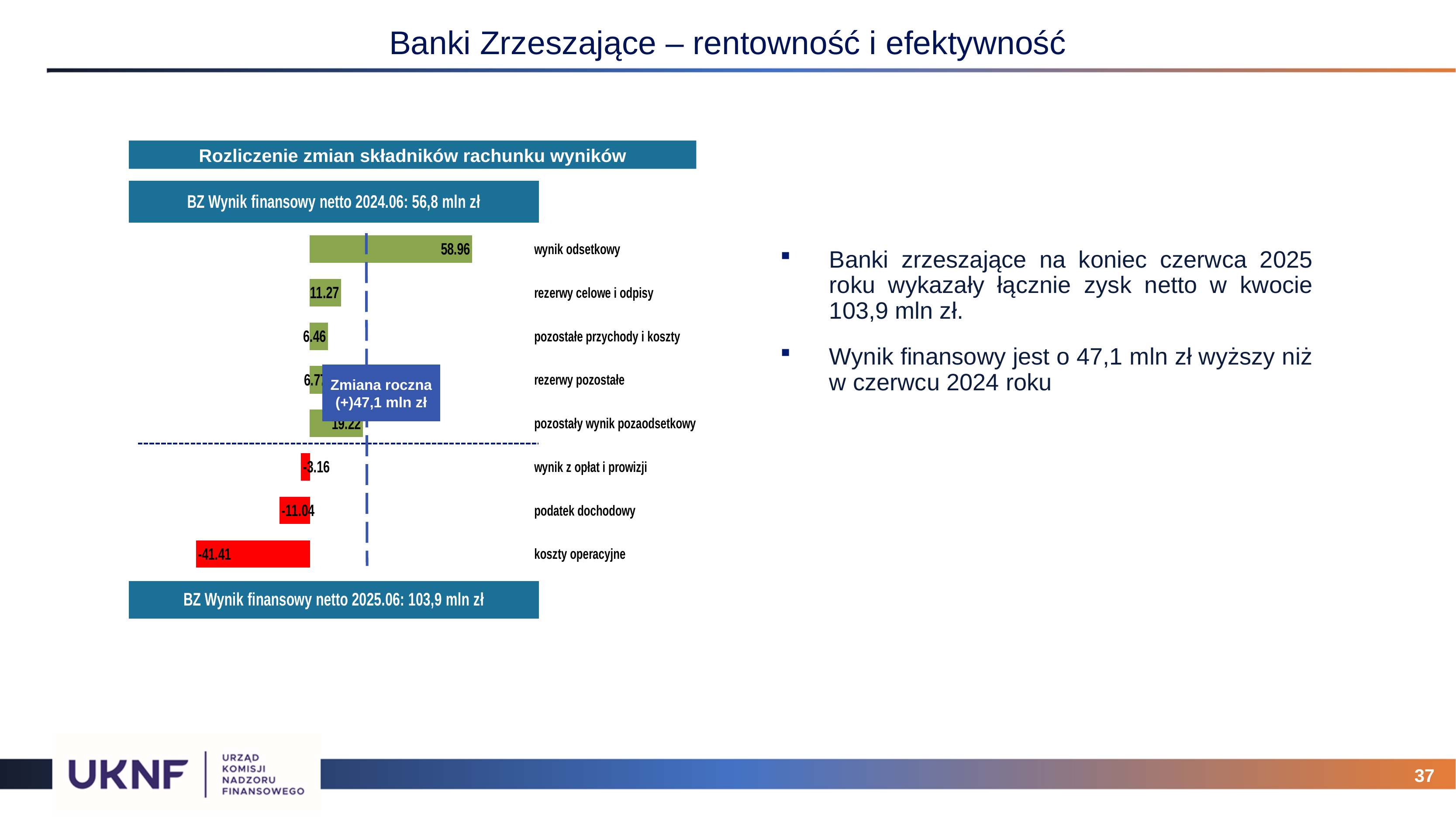
What is the difference between the values for 'wynik odsetkowy' and 'pozostały wynik pozaodsetkowy'? 39.74 How many categories are plotted in the chart? 8 What is the value shown for 'podatek dochodowy'? -11.04 Which category has the lowest value in the chart? koszty operacyjne What is the value shown for 'wynik z opłat i prowizji'? -3.16 Which is larger: the value for 'rezerwy celowe i odpisy' or for 'pozostałe przychody i koszty'? rezerwy celowe i odpisy What is the value shown for 'rezerwy celowe i odpisy'? 11.27 Which category has the highest value in the chart? wynik odsetkowy What type of chart is shown on the slide? bar chart What is the value shown for 'wynik odsetkowy'? 58.96 What is the value shown for 'koszty operacyjne'? -41.41 What is the value shown for 'pozostały wynik pozaodsetkowy'? 19.22